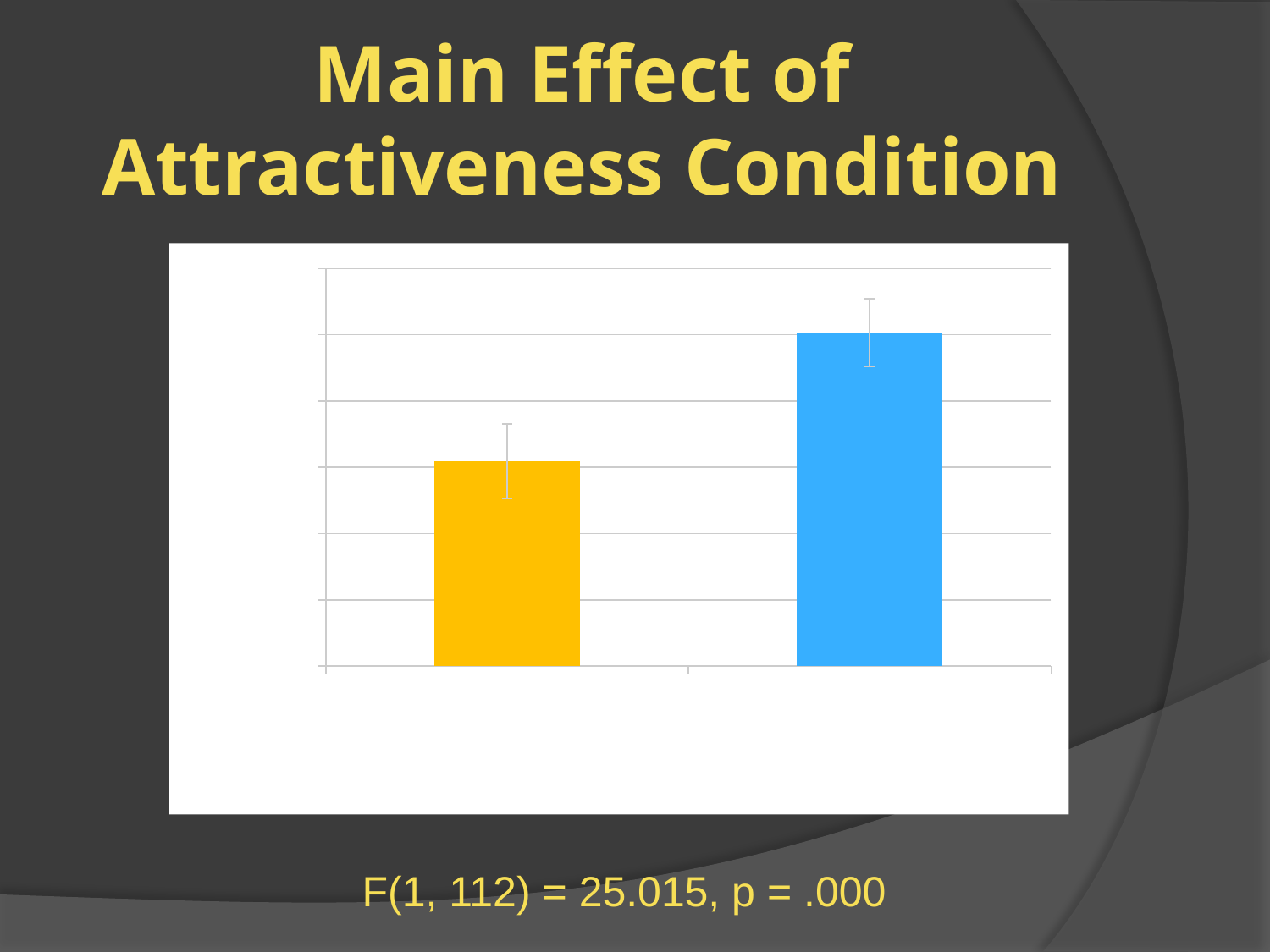
What is the title of the slide containing the chart? Main Effect of Attractiveness Condition Which bar has the highest value in the chart? the blue bar on the right How many bars are plotted in the chart? 2 What kind of chart is shown on the slide? bar chart What colour is the left bar in the chart? orange Which bar has the lowest value in the chart? the orange bar on the left Do the bar values rise or fall from left to right across the chart? rise Which bar is taller, the orange bar on the left or the blue bar on the right? the blue bar on the right